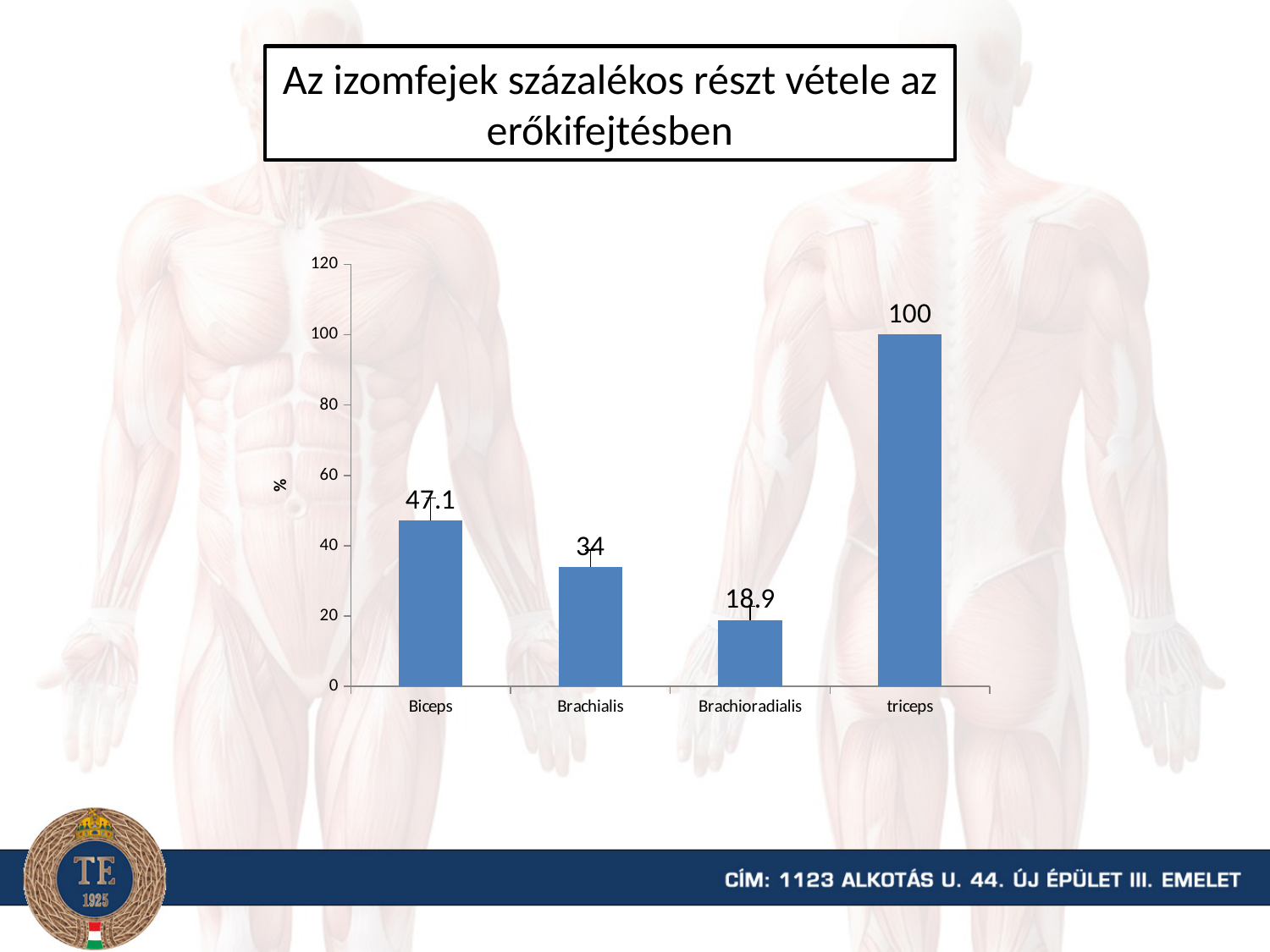
What is the value for Brachialis? 34 What is the value for triceps? 100 Which category has the lowest value? Brachioradialis Which is larger, the value for Biceps or the value for Brachialis? Biceps What is the value for Biceps? 47.1 What kind of chart is shown on the slide? bar chart What is the difference between the values for triceps and Biceps? 52.9 Which category has the highest value? triceps What is the difference between the values for Brachialis and Brachioradialis? 15.1 How many categories are shown on the x axis? 4 What is the value for Brachioradialis? 18.9 What is the label of the y axis? %